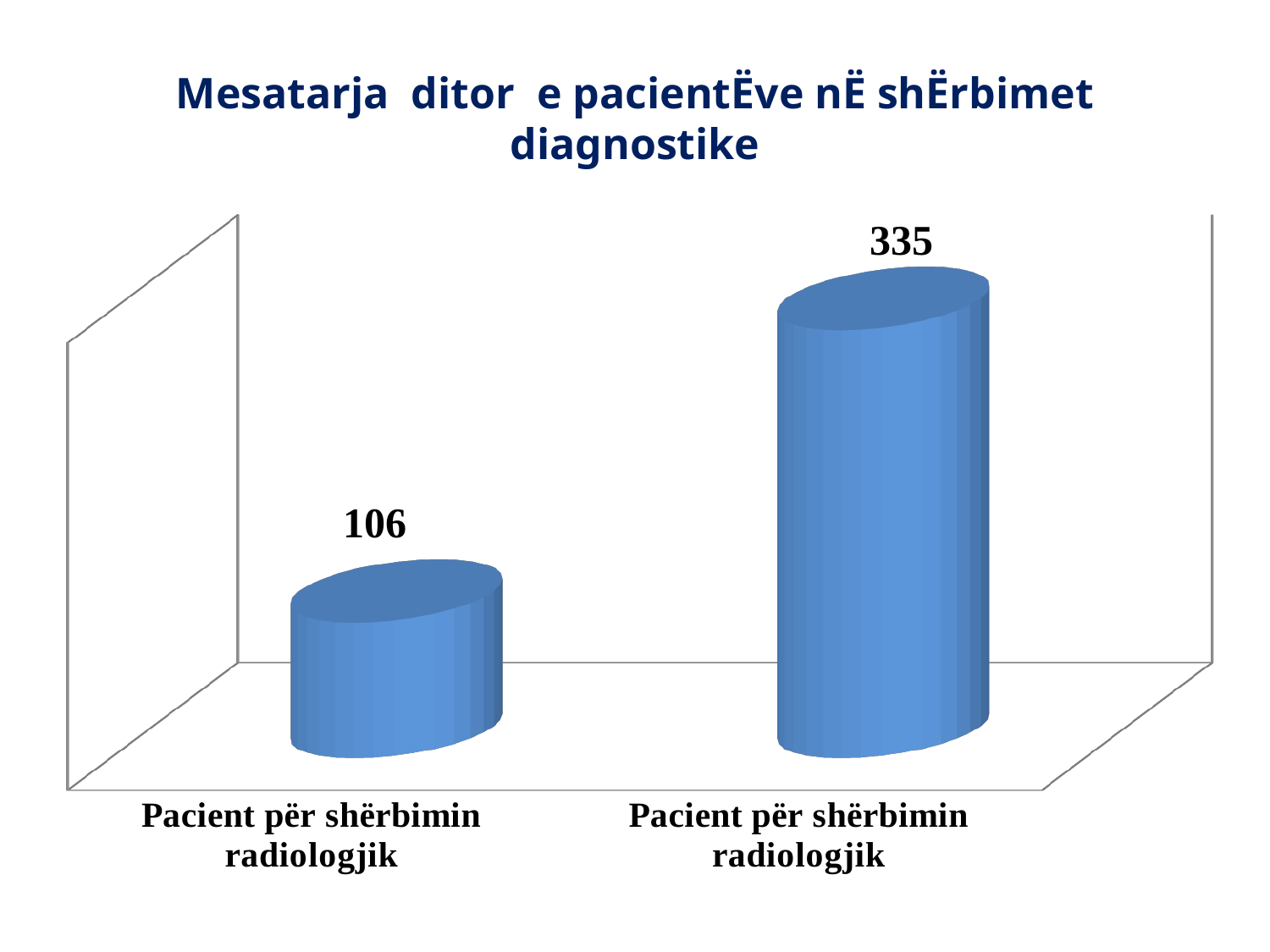
What is the value of the right bar in the chart? 335 Do the values rise or fall from left to right across the chart? rise What kind of chart is shown on the slide? bar chart Which bar has the highest value, the left or the right one? the right bar What is the title of the chart on the slide? Mesatarja ditor e pacientËve nË shËrbimet diagnostike Which bar has the lowest value, the left or the right one? the left bar Is the value of the left bar larger or smaller than the value of the right bar? smaller What is the difference between the values of the right bar and the left bar? 229 What colour are the bars in the chart? blue What is the total of the two values shown in the chart? 441 What is the value of the left bar in the chart? 106 How many bars are plotted in the chart? 2